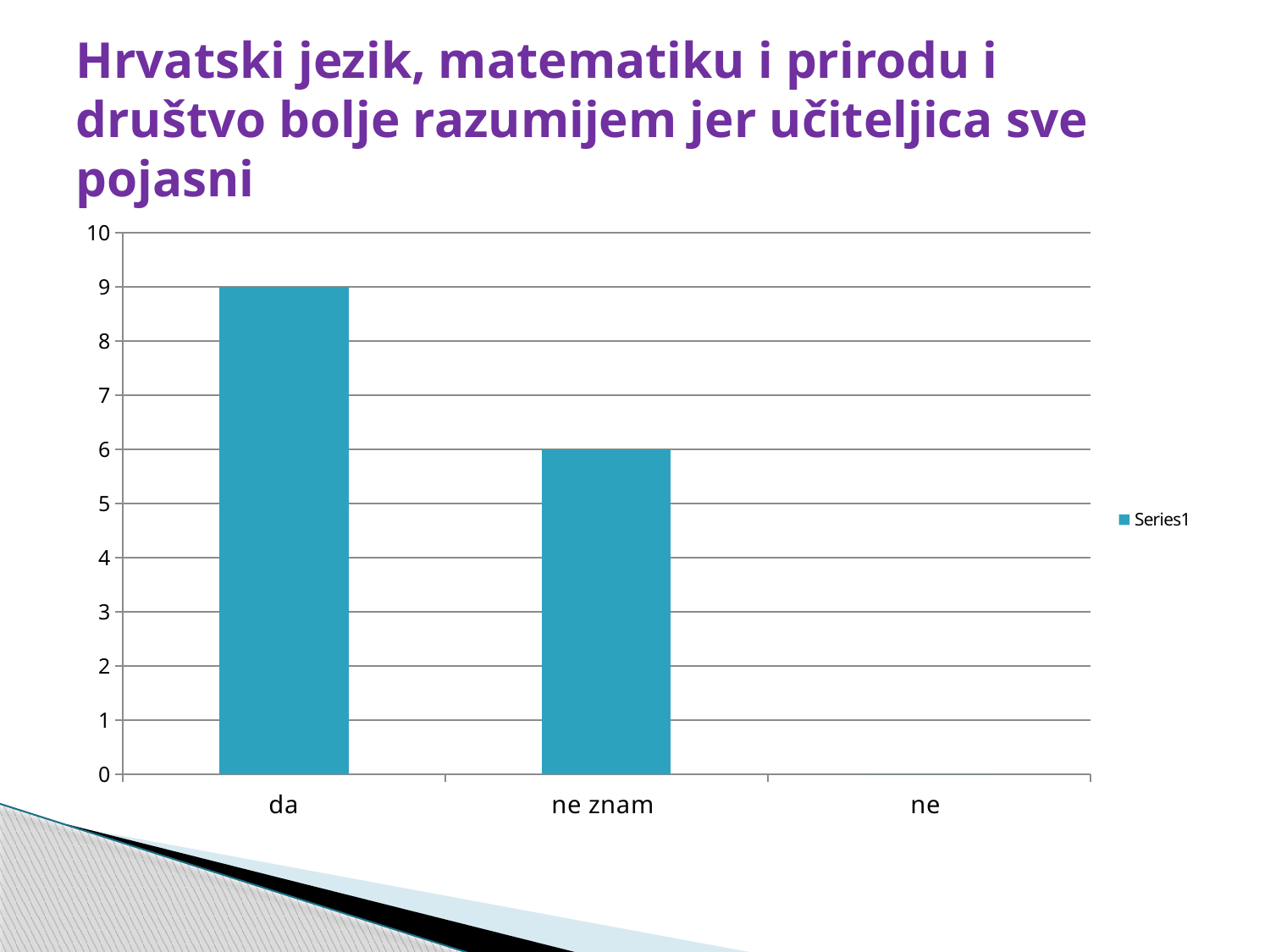
Is the value for "ne znam" greater or less than 5? greater What is the value for "ne znam"? 6 Which category has the lowest value? ne Is the value for "da" greater or less than 8? greater What is the value for "da"? 9 How many categories are shown on the x axis? 3 How many series does the legend list? 1 Which is larger, the value for "da" or the value for "ne znam"? da Which category has the highest value? da What kind of chart is shown on the slide? bar chart What is the name of the series shown in the legend? Series1 What is the difference between the values for "da" and "ne znam"? 3